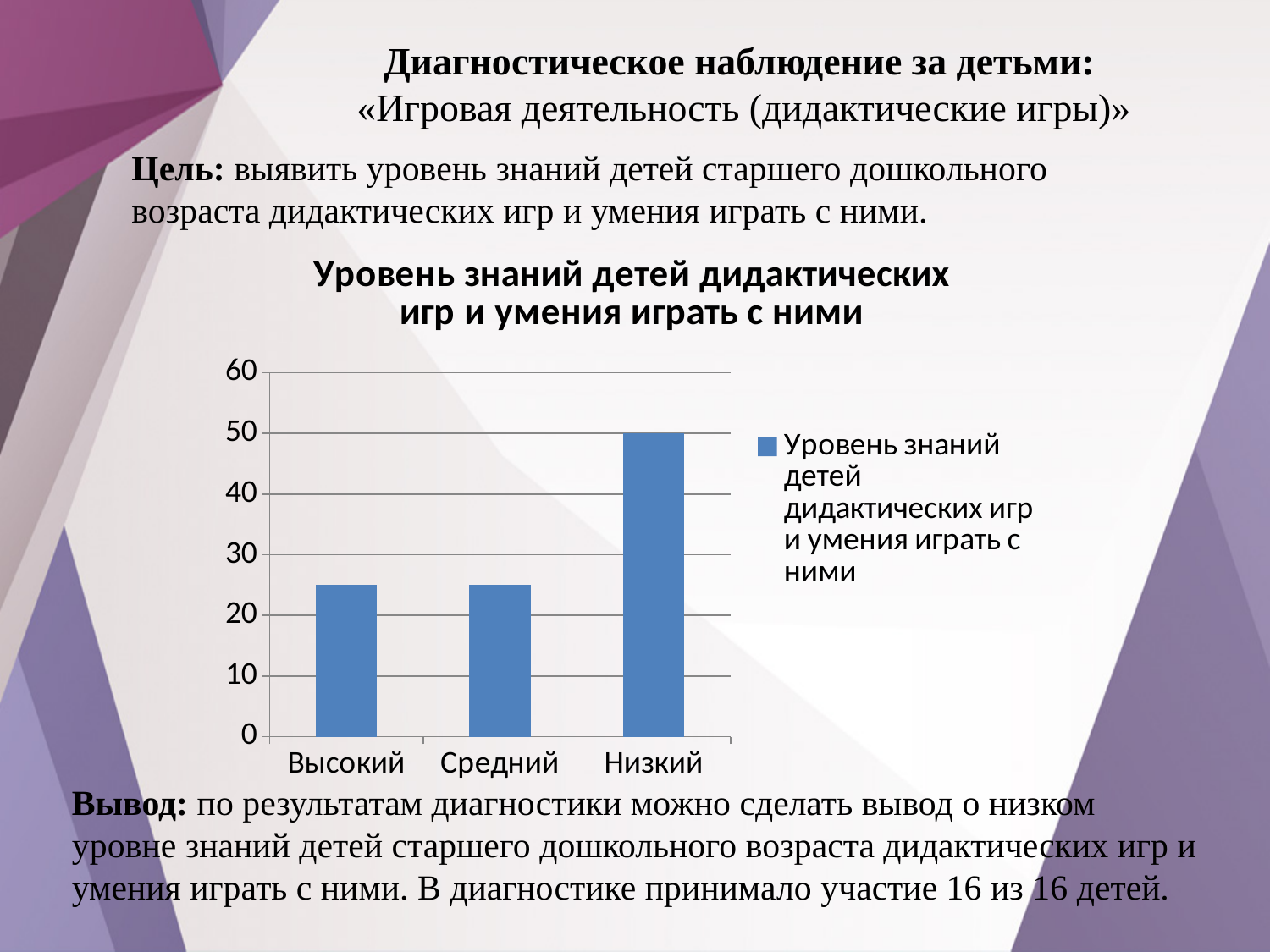
What is the title of the chart? Уровень знаний детей дидактических игр и умения играть с ними Is the value for Средний greater or less than 30? less What kind of chart is shown on the slide? bar chart Is the value for Низкий greater or less than 40? greater Is the value for Высокий greater or less than 20? greater What is the highest value shown on the chart's vertical axis? 60 Which is larger, the value for Низкий or the value for Высокий? Низкий What is the value for Низкий in the chart? 50 How many series does the chart's legend list? 1 How many categories are shown on the x axis of the chart? 3 Which category has the highest value in the chart? Низкий